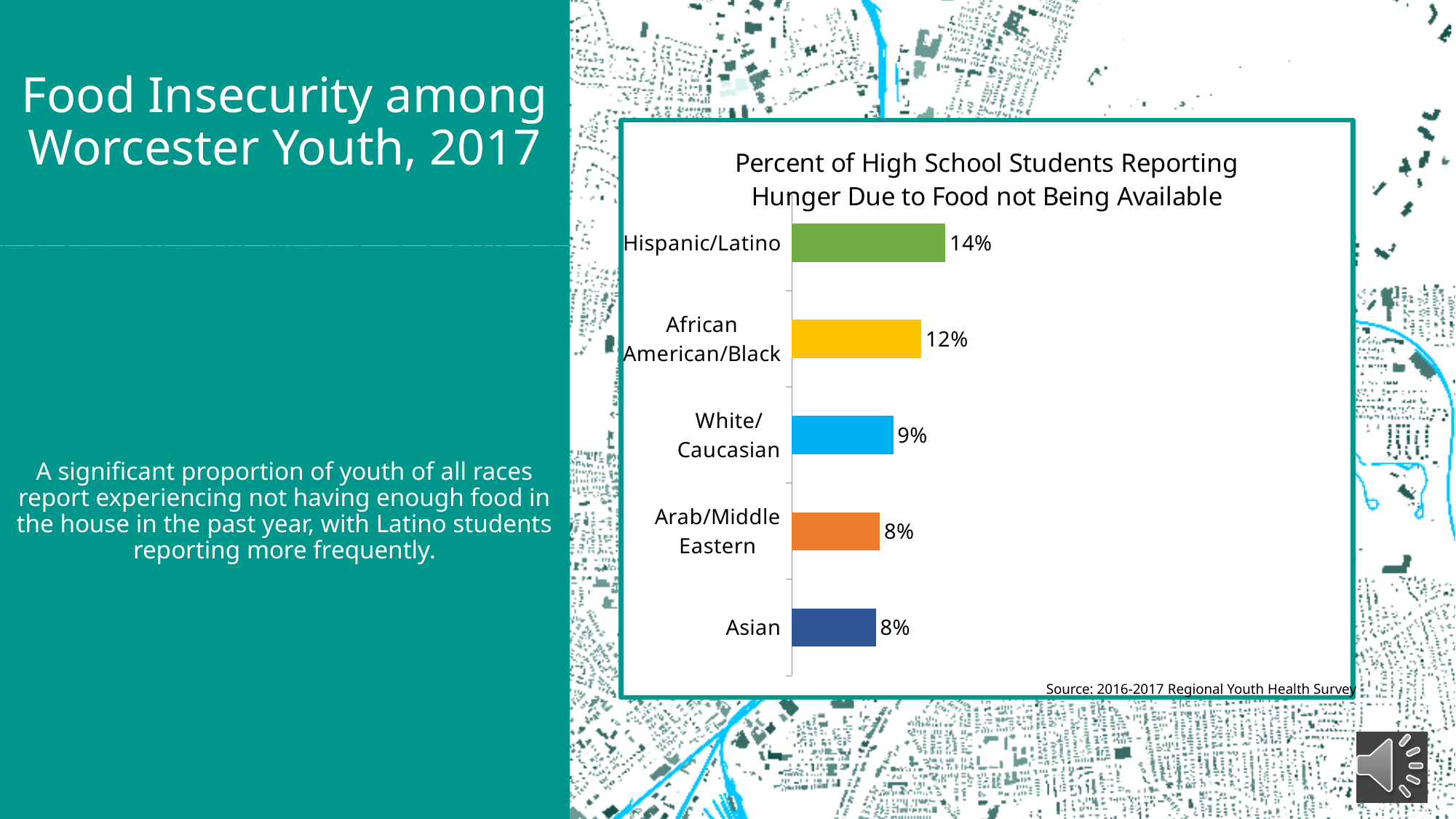
What kind of chart is shown on the slide? Bar chart What is the value shown for Arab/Middle Eastern students? 8% What is the value shown for African American/Black students? 12% Which group has the highest percentage of students reporting hunger? Hispanic/Latino What is the difference between the Hispanic/Latino value and the African American/Black value? 2% What colour is the bar for Asian students? Dark blue Which is larger, the value for White/Caucasian or the value for Arab/Middle Eastern? White/Caucasian What is the title of the chart? Percent of High School Students Reporting Hunger Due to Food not Being Available What percent of Hispanic/Latino high school students reported hunger due to food not being available? 14% How many racial/ethnic groups are shown in the chart? 5 What percent of White/Caucasian students reported hunger due to food not being available? 9% What is the difference between the Hispanic/Latino value and the Asian value? 6%